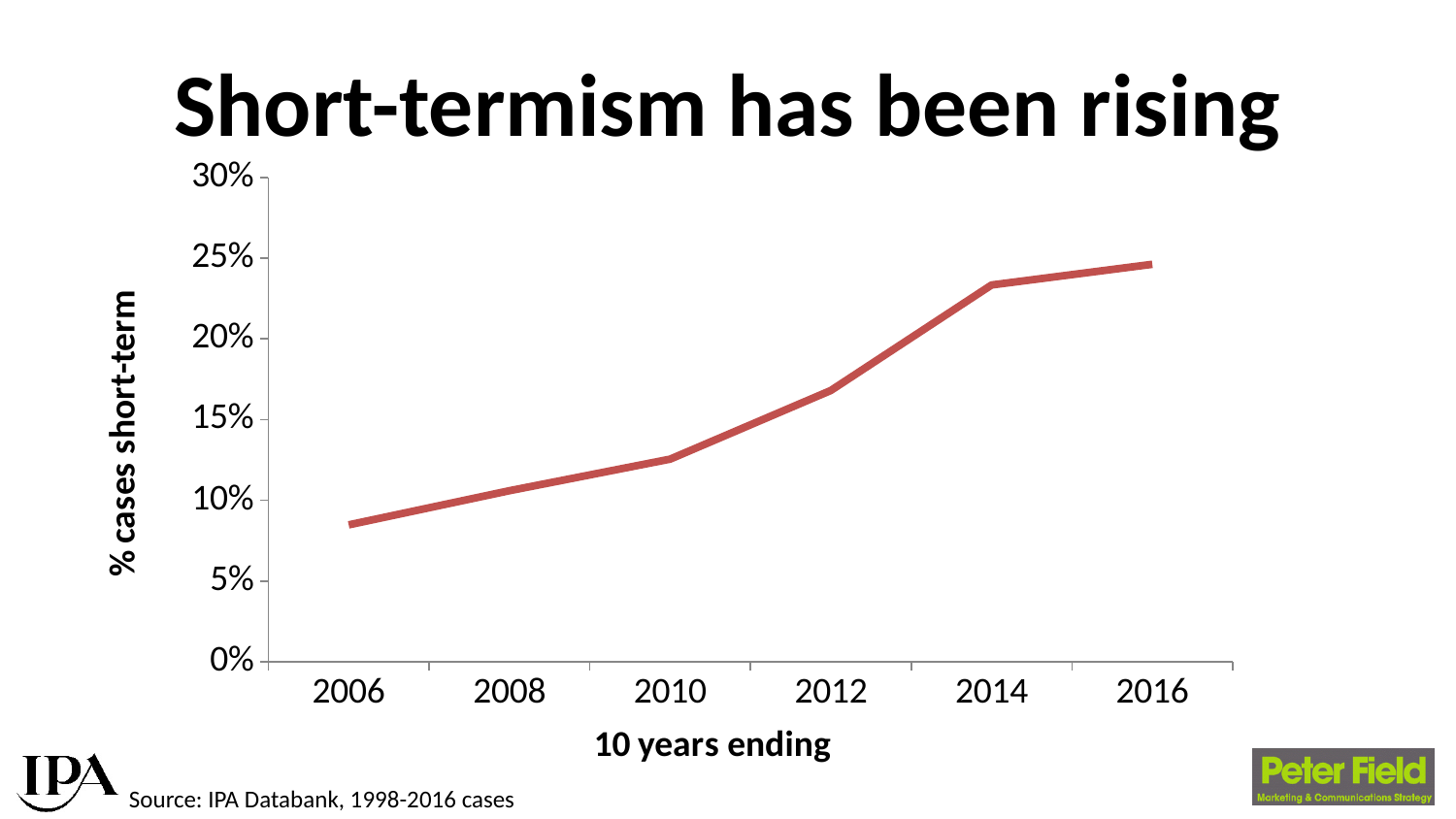
What is the title of the chart? Short-termism has been rising Which year has the lowest % cases short-term? 2006 How many years are labelled along the x axis of the chart? 6 Do the values rise or fall from 2006 to 2016? Rise What kind of chart is shown on the slide? Line chart Which year has the highest % cases short-term? 2016 Is the value for 2006 greater or less than 10%? less Which year has the larger value, 2012 or 2014? 2014 Is the value for 2012 greater or less than 15%? greater Is the value for 2014 greater or less than 20%? greater What is the label on the vertical axis of the chart? % cases short-term